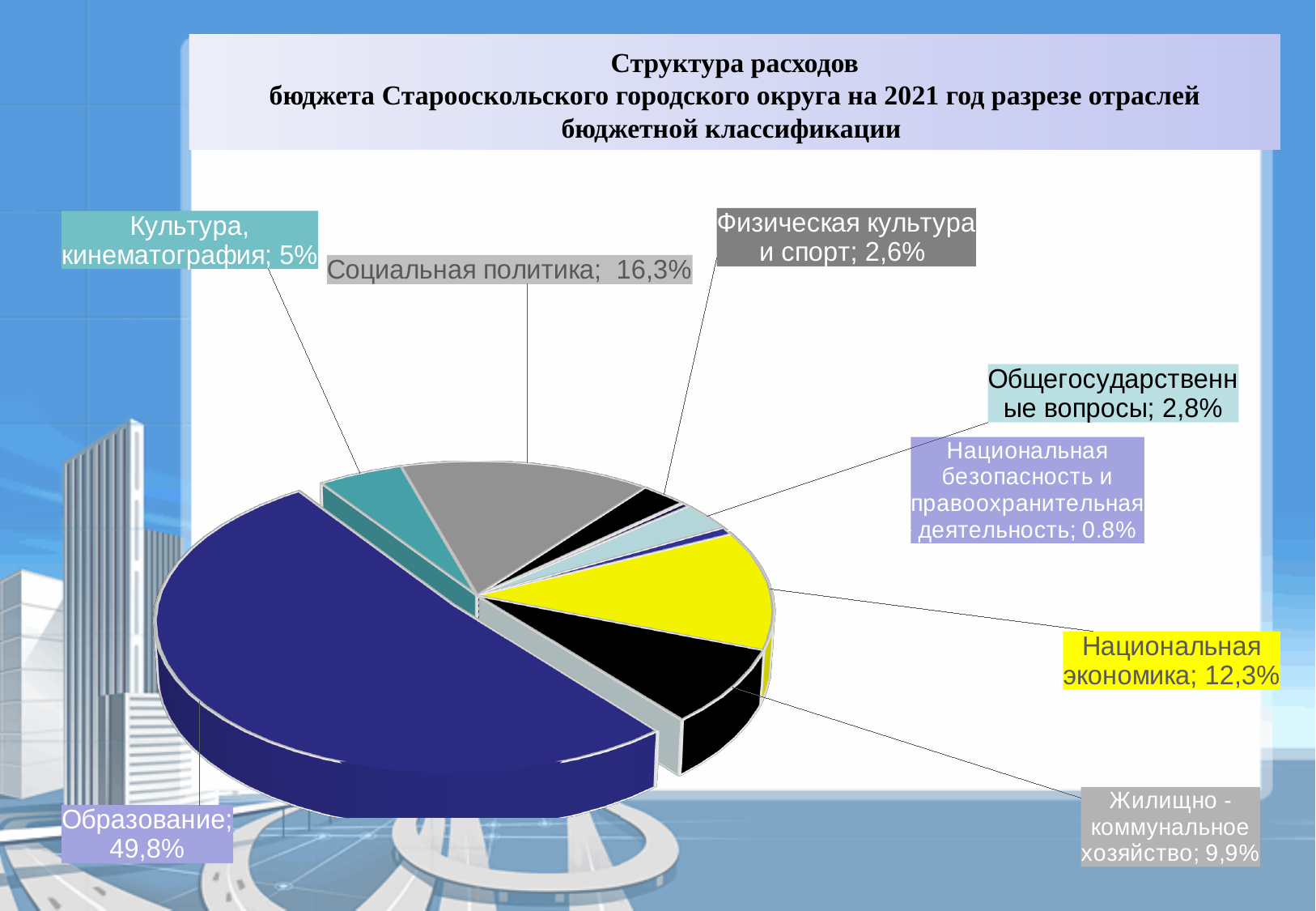
What is the value shown for Социальная политика? 16,3% For which year does the chart show the budget expenditure structure? 2021 What kind of chart is shown on the slide? pie chart Which is larger: the share for Общегосударственные вопросы or for Физическая культура и спорт? Общегосударственные вопросы Which category has the smallest share of the pie? Национальная безопасность и правоохранительная деятельность What is the difference between the shares of Социальная политика and Национальная экономика? 4 percentage points Which category has the largest share of the pie? Образование How many categories are shown in the pie chart? 8 What share is shown for Национальная безопасность и правоохранительная деятельность? 0.8% What share of the budget expenditure goes to Образование? 49,8% What percentage is labelled for Национальная экономика? 12,3% What is the value for Жилищно-коммунальное хозяйство? 9,9%